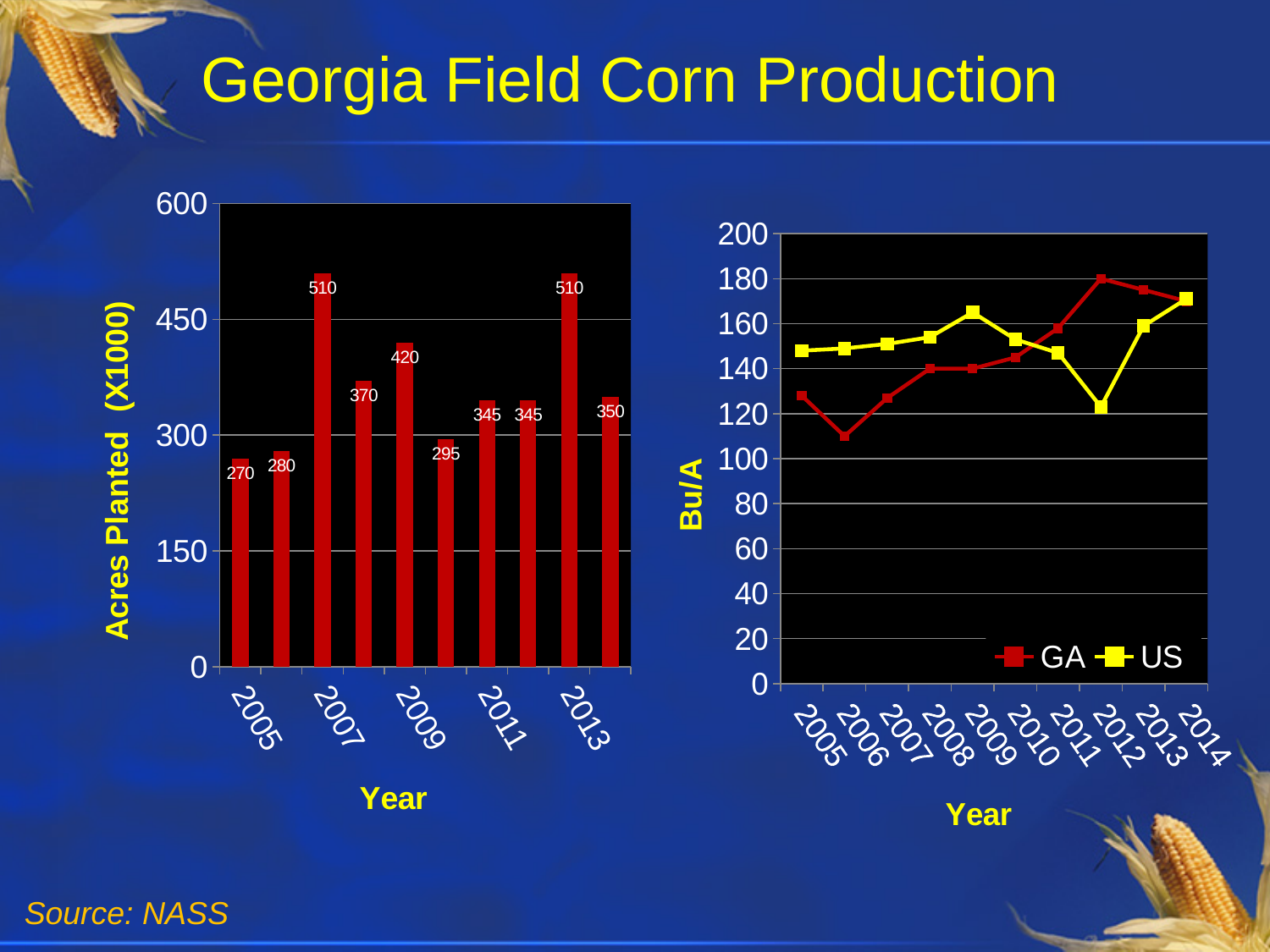
On the left chart (Acres Planted), what is the value for 2005? 270 On the right chart (Bu/A), is the GA value for 2012 greater or less than 160? greater On the left chart (Acres Planted), what is the value for 2007? 510 What kind of chart is the left chart (Acres Planted)? bar chart On the right chart (Bu/A), which series has the higher value in 2006, GA or US? US On the right chart (Bu/A), is the US value for 2012 greater or less than 140? less On the left chart (Acres Planted), what is the difference between the values for 2009 and 2005? 150 On the right chart (Bu/A), how many series does the legend list? 2 On the left chart (Acres Planted), which year has the lowest value? 2005 On the left chart (Acres Planted), what is the value for 2009? 420 On the left chart (Acres Planted), how many bars are plotted? 10 On the left chart (Acres Planted), which is larger, the value for 2011 or the value for 2013? 2013